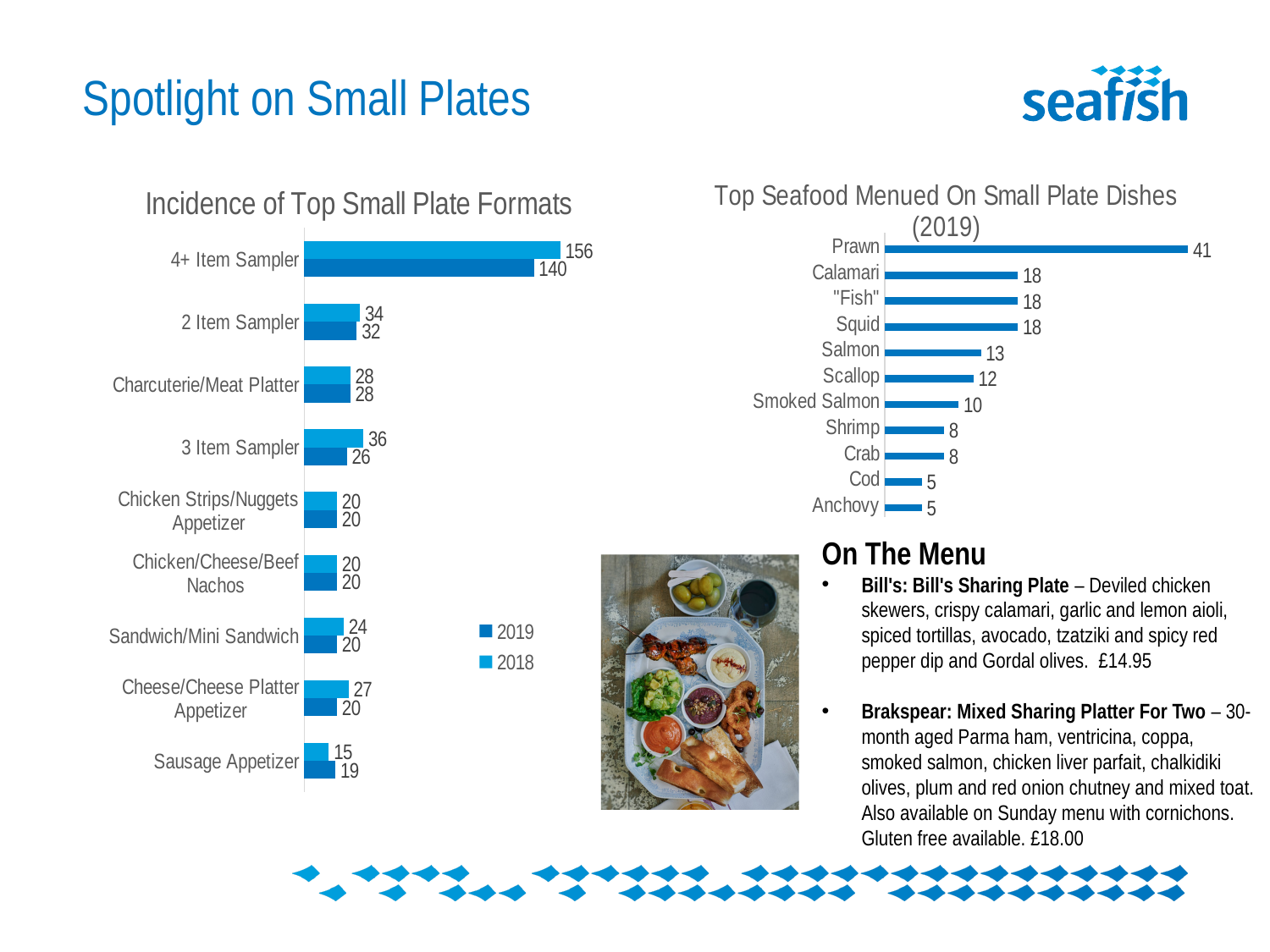
What kind of chart is the 'Top Seafood Menued On Small Plate Dishes (2019)' chart? Bar chart In the 'Top Seafood Menued On Small Plate Dishes (2019)' chart, what is the difference between the values for Prawn and Calamari? 23 In the 'Incidence of Top Small Plate Formats' chart, what is the 2019 value for 4+ Item Sampler? 140 In the 'Incidence of Top Small Plate Formats' chart, which category has the highest 2019 value? 4+ Item Sampler In the 'Incidence of Top Small Plate Formats' chart, what is the 2018 value for Sausage Appetizer? 15 How many categories are shown in the 'Incidence of Top Small Plate Formats' chart? 9 In the 'Incidence of Top Small Plate Formats' chart, which year has the larger value for 3 Item Sampler, 2019 or 2018? 2018 How many series does the legend of the 'Incidence of Top Small Plate Formats' chart list? 2 In the 'Top Seafood Menued On Small Plate Dishes (2019)' chart, which seafood has the highest value? Prawn In the 'Incidence of Top Small Plate Formats' chart, what is the difference between the 2019 and 2018 values for 4+ Item Sampler? 16 How many seafood categories are shown in the 'Top Seafood Menued On Small Plate Dishes (2019)' chart? 11 In the 'Top Seafood Menued On Small Plate Dishes (2019)' chart, what is the value for Smoked Salmon? 10